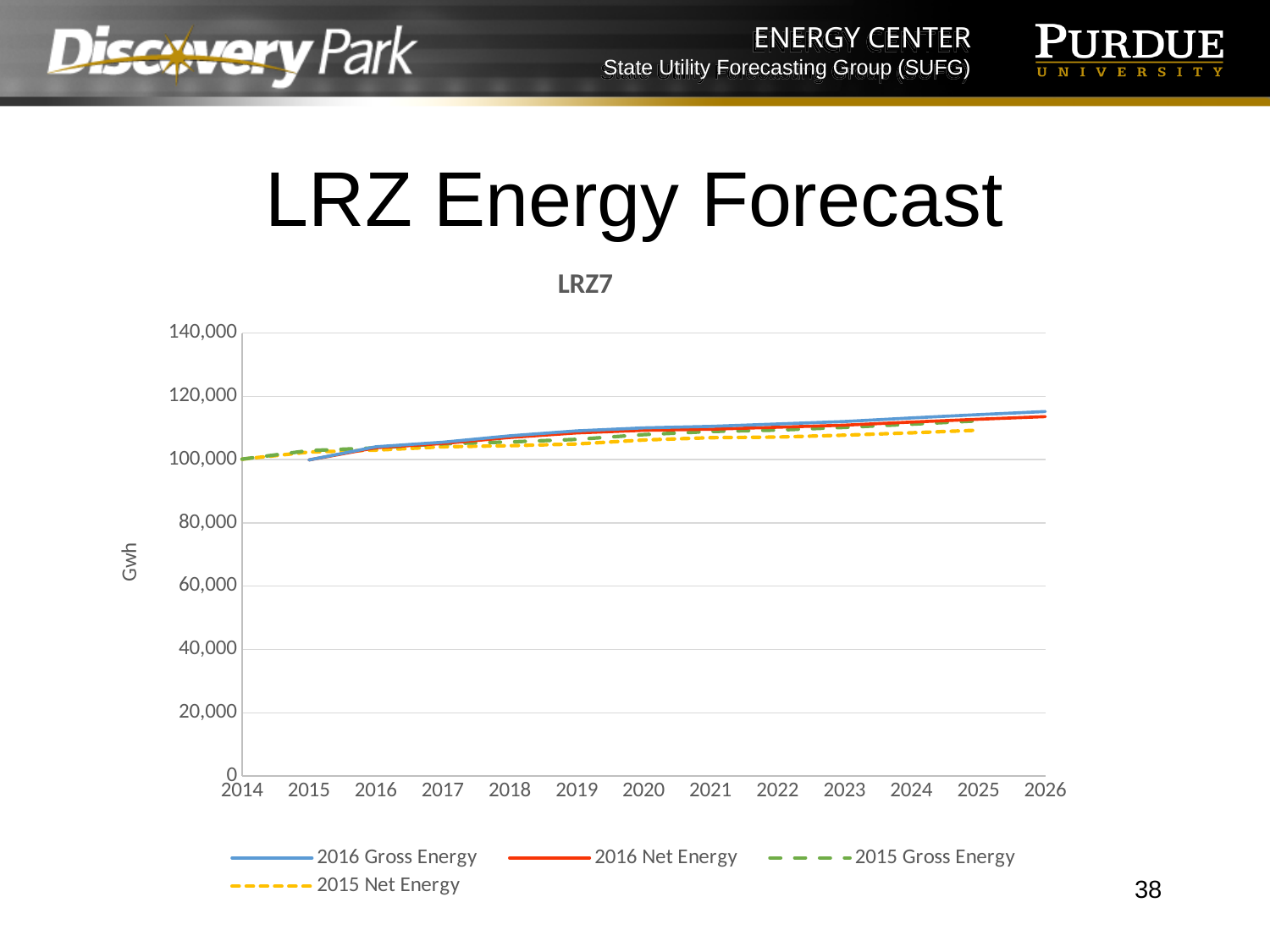
What unit is shown on the vertical axis of the LRZ7 chart? Gwh In 2025, which is larger: 2016 Gross Energy or 2015 Net Energy? 2016 Gross Energy Is the value for 2015 Net Energy in 2025 greater or less than 100,000? greater How many years are labelled along the x axis of the LRZ7 chart? 13 What is the title of the chart on the slide? LRZ7 How many series does the legend of the LRZ7 chart list? 4 What kind of chart is shown on the slide? line chart Is the value for 2016 Gross Energy in 2026 greater or less than 120,000? less Does the 2016 Gross Energy line rise or fall from 2015 to 2026? rise Is the value for 2016 Gross Energy in 2026 greater or less than 100,000? greater Does the 2015 Net Energy line rise or fall from 2014 to 2025? rise